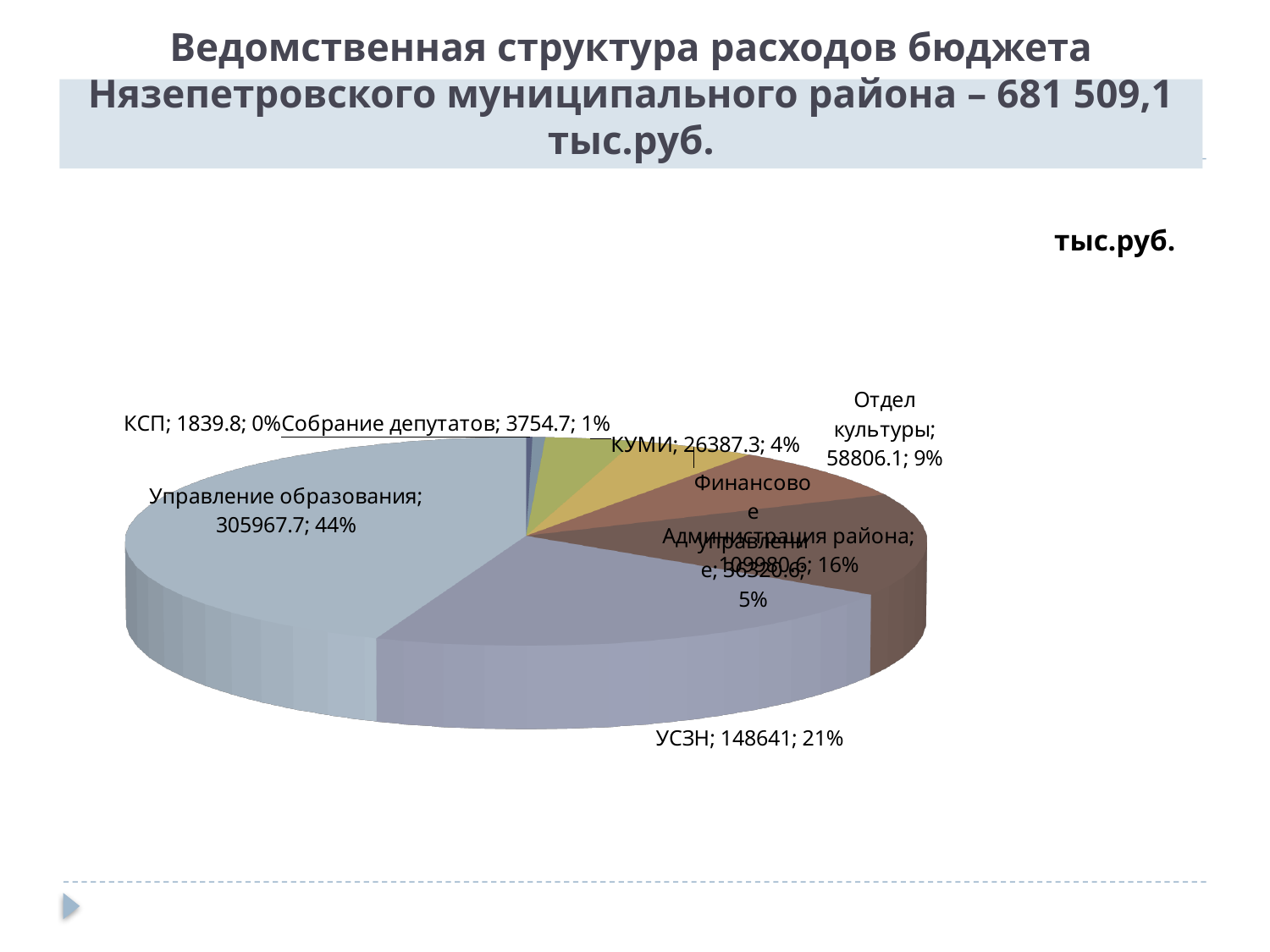
What is the value for КУМИ? 26387.3 What is the value for Отдел культуры? 58806.1 Which category has the largest slice of the pie? Управление образования What is the value for УСЗН? 148641 What kind of chart is shown on the slide? pie chart What is the value for Администрация района? 109980.6 What is the value for Управление образования? 305967.7 What share of the pie does Управление образования take? 44% What is the difference between the values for Собрание депутатов and КСП? 1914.9 Which category has the smallest slice of the pie? КСП Which is larger, the value for УСЗН or the value for Администрация района? УСЗН What share of the pie does УСЗН take? 21%